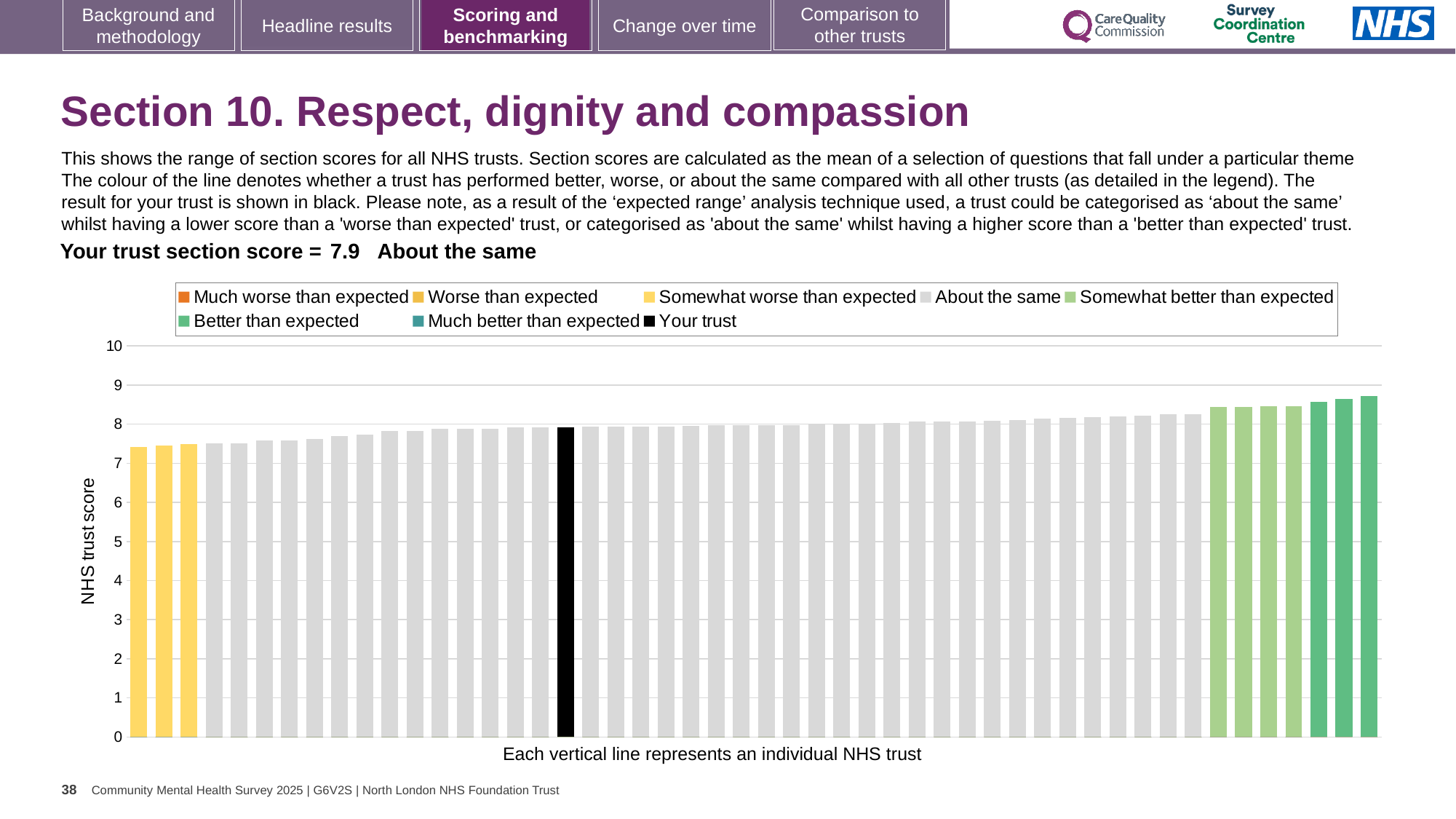
What is the section score for your trust shown on the slide? 7.9 Which category is your trust placed in for this section? About the same How many entries does the chart legend list? 8 Is the value of the tallest bar on the right greater or less than 8? greater Is the value of the black 'Your trust' bar greater or less than 5? greater Is the black 'Your trust' bar higher or lower than the yellow bars on the left? Higher What is the label on the vertical axis of the chart? NHS trust score How many bars are coloured yellow (Somewhat worse than expected)? 3 What kind of chart is shown on the slide? Bar chart Do the bar values rise or fall from left to right along the x axis? Rise How many bars are coloured dark green (Better than expected)? 3 Is the value of the leftmost (lowest) bar greater or less than 7? greater